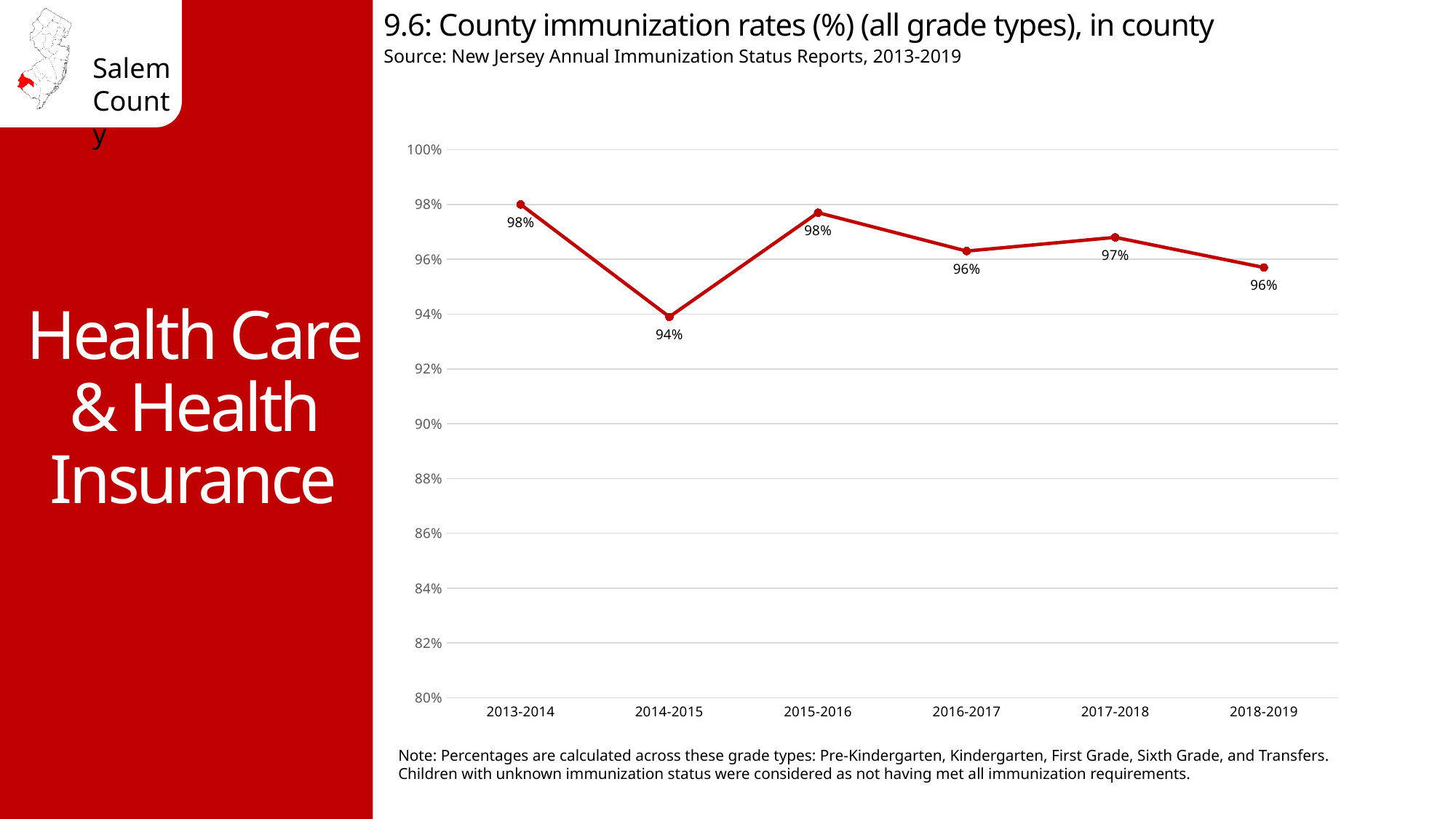
What is the county immunization rate for 2013-2014? 98% Does the immunization rate rise or fall from 2015-2016 to 2016-2017? fall Which has a higher immunization rate, 2017-2018 or 2018-2019? 2017-2018 What is the county immunization rate for 2016-2017? 96% Which school year has the lowest immunization rate? 2014-2015 What is the county immunization rate for 2017-2018? 97% How many school years are plotted on the chart? 6 What is the difference between the immunization rates for 2013-2014 and 2014-2015? 4 percentage points What is the source cited for the chart? New Jersey Annual Immunization Status Reports, 2013-2019 Is the immunization rate for 2014-2015 greater or less than 96%? less What kind of chart is shown on the slide? line chart What is the county immunization rate for 2014-2015? 94%